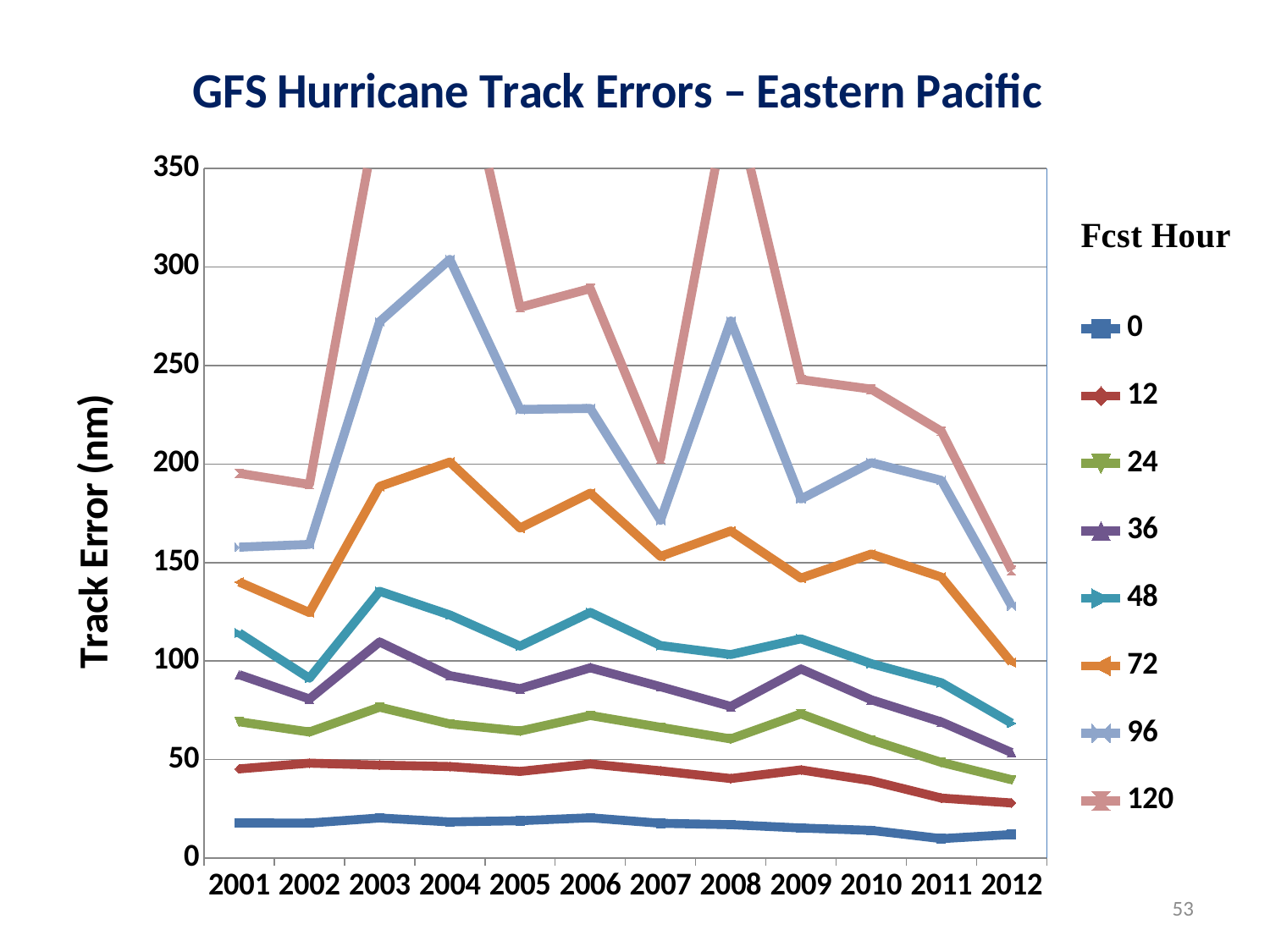
Is the value for the 72-hour series in 2012 greater or less than 150? less In which year does the 72-hour series reach its lowest value? 2012 What is the label on the vertical axis? Track Error (nm) Is the value for the 96-hour series in 2004 greater or less than 250? greater For the 48-hour series, which year has the larger track error, 2003 or 2012? 2003 How many years are shown along the x axis? 12 How many forecast-hour series does the legend list? 8 Is the value for the 0-hour series in 2012 greater or less than 50? less What is the title of the chart? GFS Hurricane Track Errors – Eastern Pacific In which year does the 96-hour series reach its highest value? 2004 What kind of chart is shown on the slide? line chart